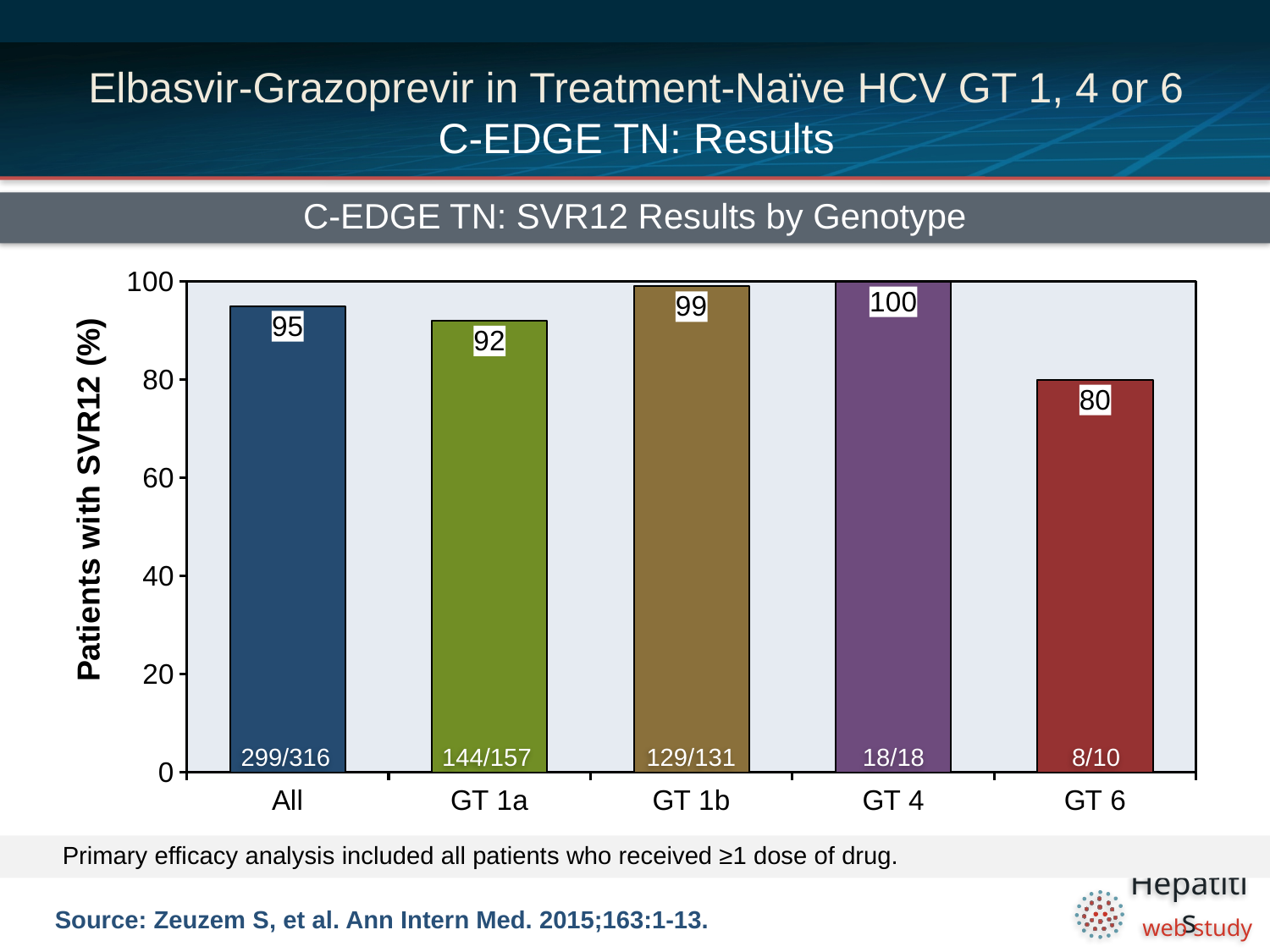
What is the SVR12 rate for GT 6? 80 What is the difference in SVR12 rate between GT 4 and GT 6? 20 What kind of chart is shown on the slide? Bar chart What is the SVR12 rate for the All group? 95 Which has a higher SVR12 rate, GT 1a or GT 1b? GT 1b What is the title of the chart? C-EDGE TN: SVR12 Results by Genotype How many genotype groups are shown on the x axis? 5 Which genotype group has the highest SVR12 rate? GT 4 Which genotype group has the lowest SVR12 rate? GT 6 What is the SVR12 rate for GT 1a? 92 What fraction of patients is shown inside the GT 1b bar? 129/131 What is the difference in SVR12 rate between GT 1b and GT 1a? 7